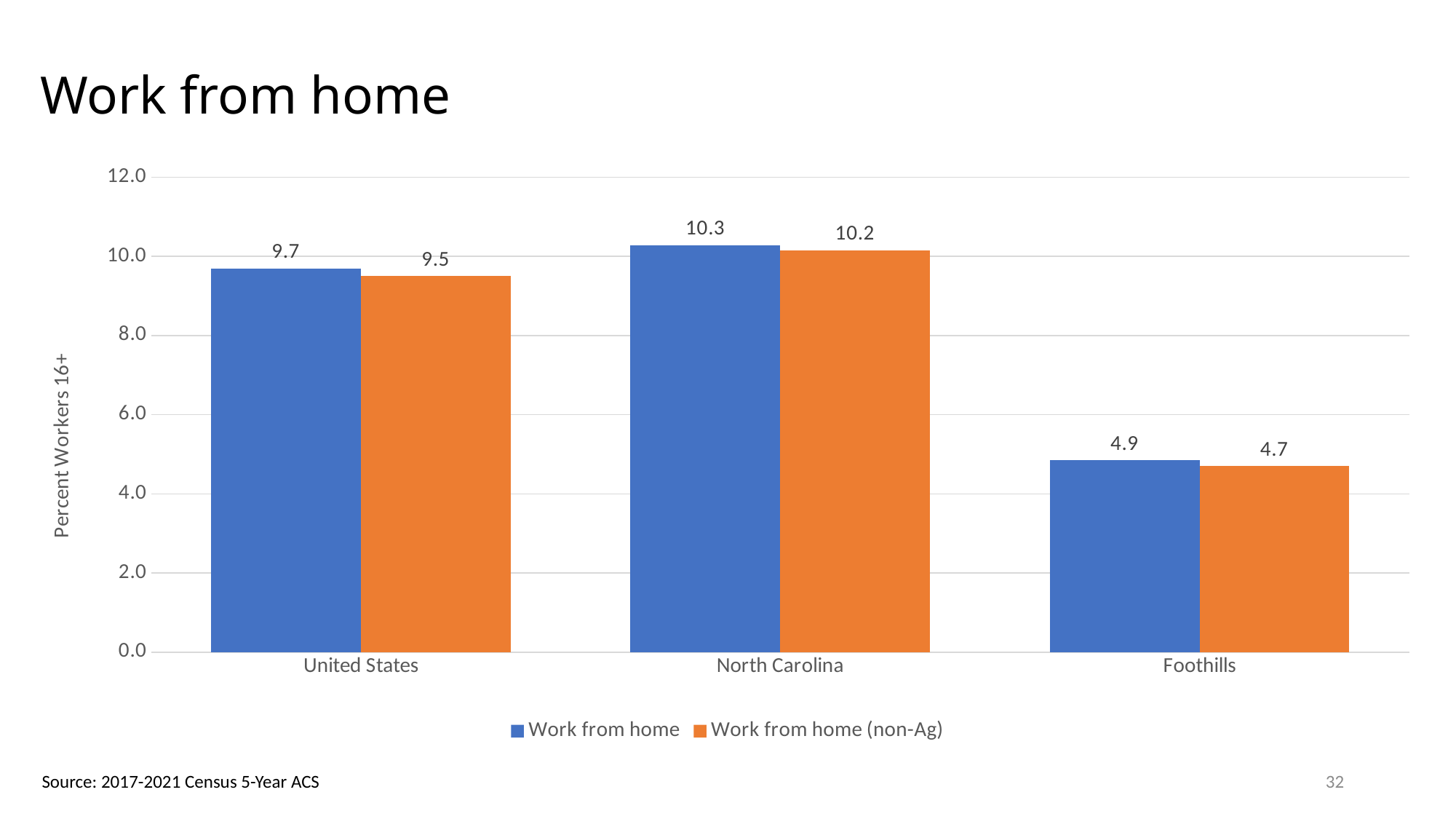
How many series does the legend list? 2 What is the label of the y axis? Percent Workers 16+ Is the 'Work from home' value for Foothills greater or less than 6.0? less Which category has the highest 'Work from home' value? North Carolina What kind of chart is shown on the slide? bar chart Which category has the lowest 'Work from home (non-Ag)' value? Foothills How many categories are shown on the x axis? 3 What is the 'Work from home (non-Ag)' value for Foothills? 4.7 What is the 'Work from home' value for the United States? 9.7 What is the difference between the 'Work from home' values for North Carolina and Foothills? 5.4 What is the 'Work from home' value for North Carolina? 10.3 Which is larger: the 'Work from home' value for the United States or for Foothills? United States